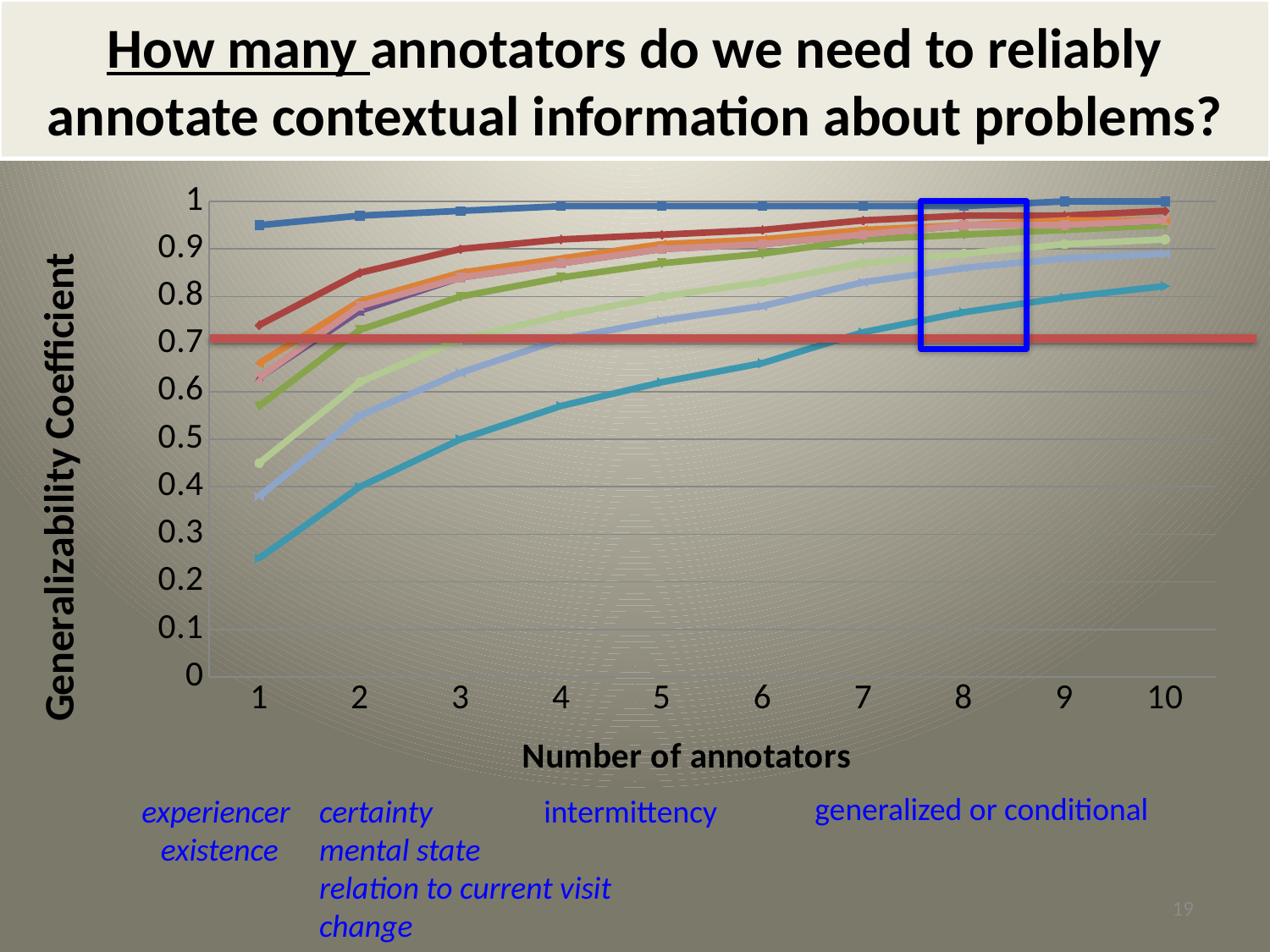
Is the value of the lowest line at 5 annotators greater or less than 0.7? less Do the plotted lines generally rise or fall as the number of annotators increases? rise How many values of the number of annotators are plotted along the x axis? 10 What kind of chart is shown on the slide? line chart Which number of annotators is highlighted by the blue box on the chart? 8 What is the title of the x axis? Number of annotators At which y-axis value is the horizontal red reference line drawn? 0.7 Is the value of the topmost line at 10 annotators greater or less than 0.9? greater